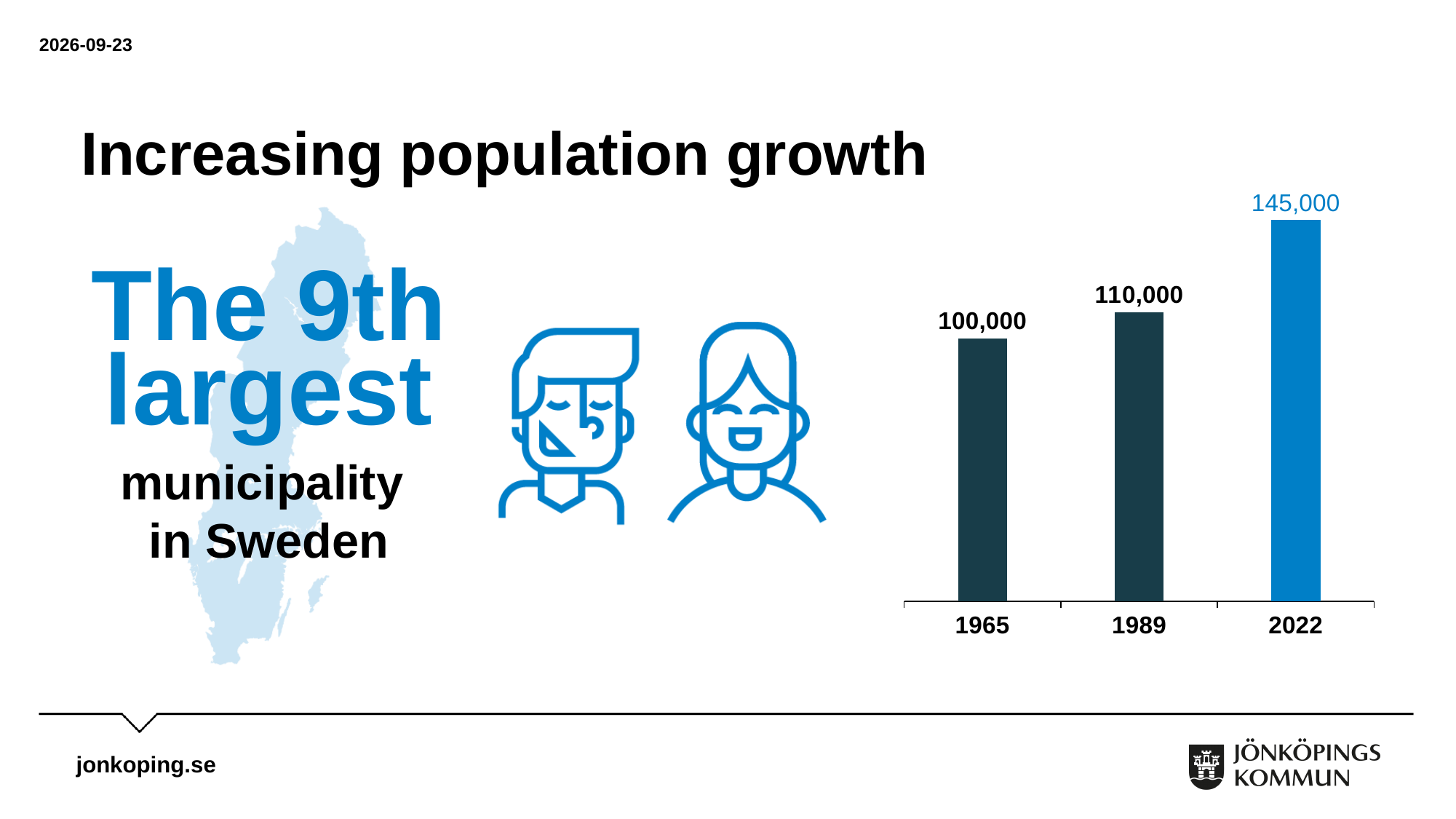
What is the difference between the values for 1989 and 1965? 10,000 What kind of chart is shown on the slide? bar chart Which year has the lowest value? 1965 What is the value shown for 2022? 145,000 Which bar is coloured differently from the others? 2022 Which is larger, the value for 1989 or the value for 2022? 2022 Do the values rise or fall from 1965 to 2022? rise Which year has the highest value? 2022 What is the value shown for 1965? 100,000 What is the value shown for 1989? 110,000 How many years are shown on the chart? 3 What is the difference between the values for 2022 and 1989? 35,000